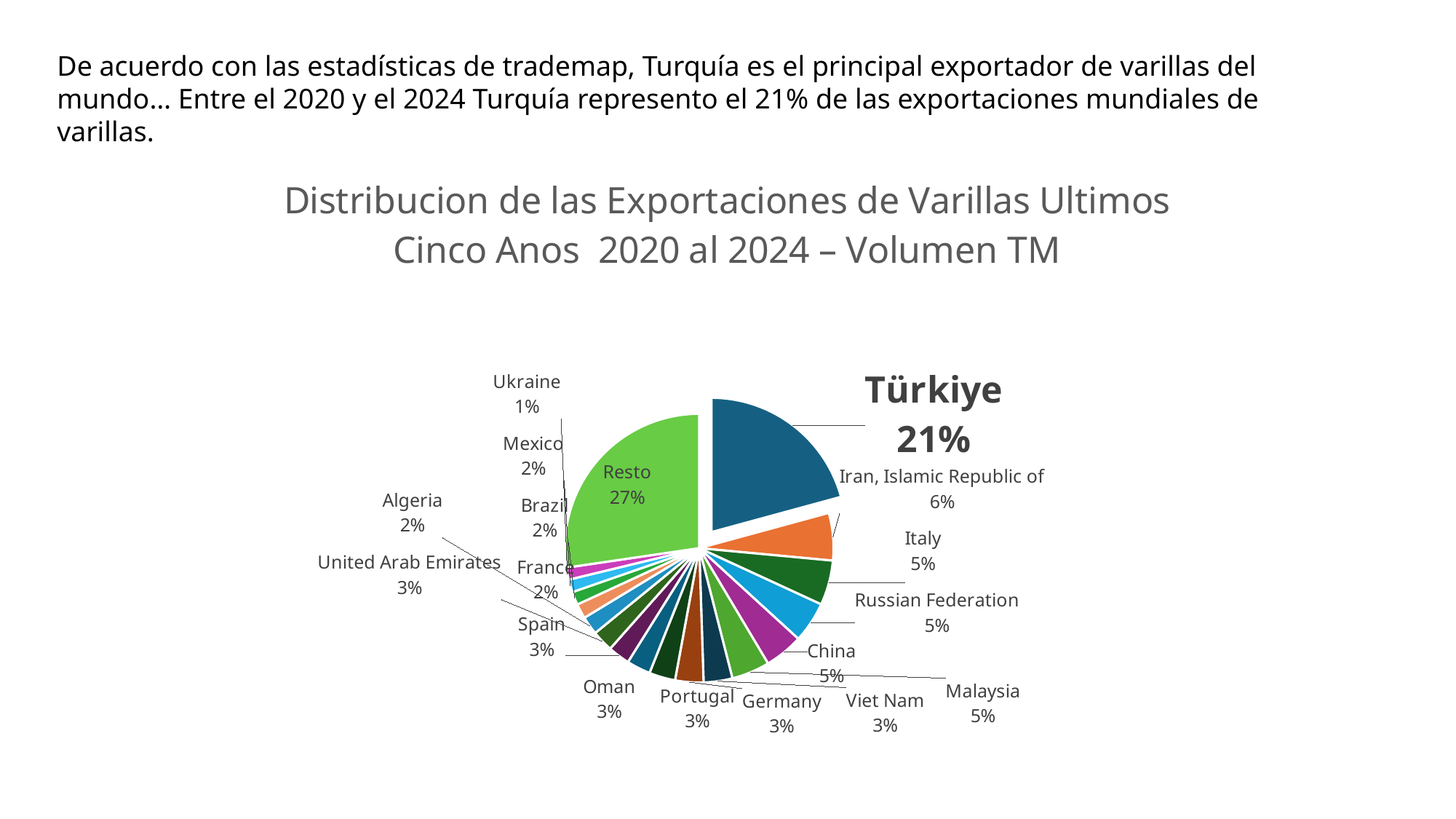
What percentage is shown for Ukraine? 1% How many slices does the pie chart have? 18 Which slice of the pie is the smallest? Ukraine Which has a larger share, Italy or Viet Nam? Italy What percentage is shown for Resto? 27% What kind of chart is shown on the slide? pie chart What is the difference in percentage points between Türkiye and Iran, Islamic Republic of? 15 What is the title of the chart? Distribucion de las Exportaciones de Varillas Ultimos Cinco Anos 2020 al 2024 – Volumen TM What percentage is shown for Malaysia? 5% What percentage is shown for Iran, Islamic Republic of? 6% Which slice of the pie is the largest? Resto What share of the pie does Türkiye hold? 21%